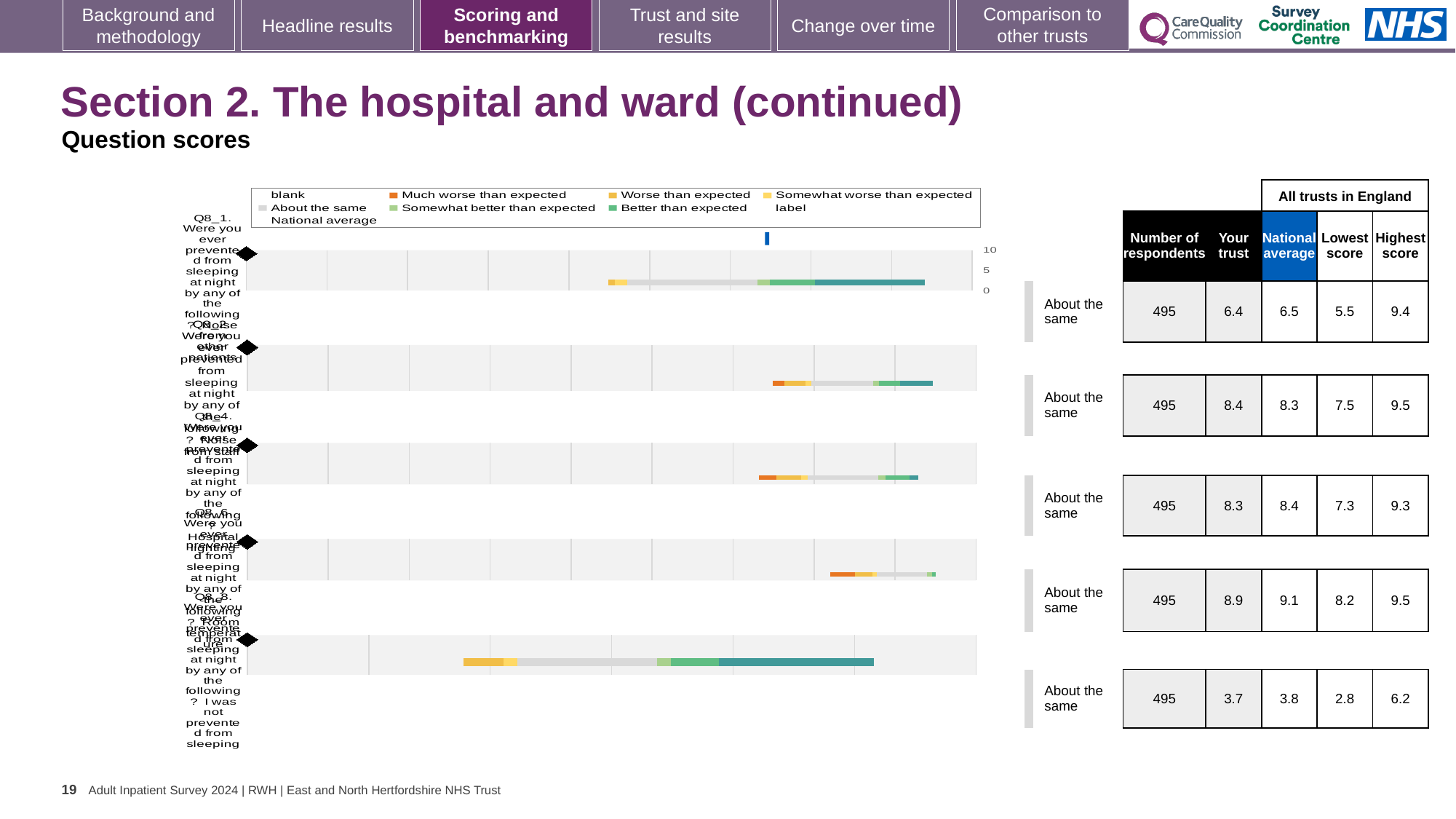
How many question rows (bars) are plotted in the chart? 5 Which legend entry is shown in teal (dark green) in the chart? Better than expected Which legend entry is shown in dark orange in the chart? Much worse than expected What benchmark category is shown next to every bar in the chart? About the same What kind of chart is shown on the slide? Bar chart What is the maximum value shown on the chart's axis? 10